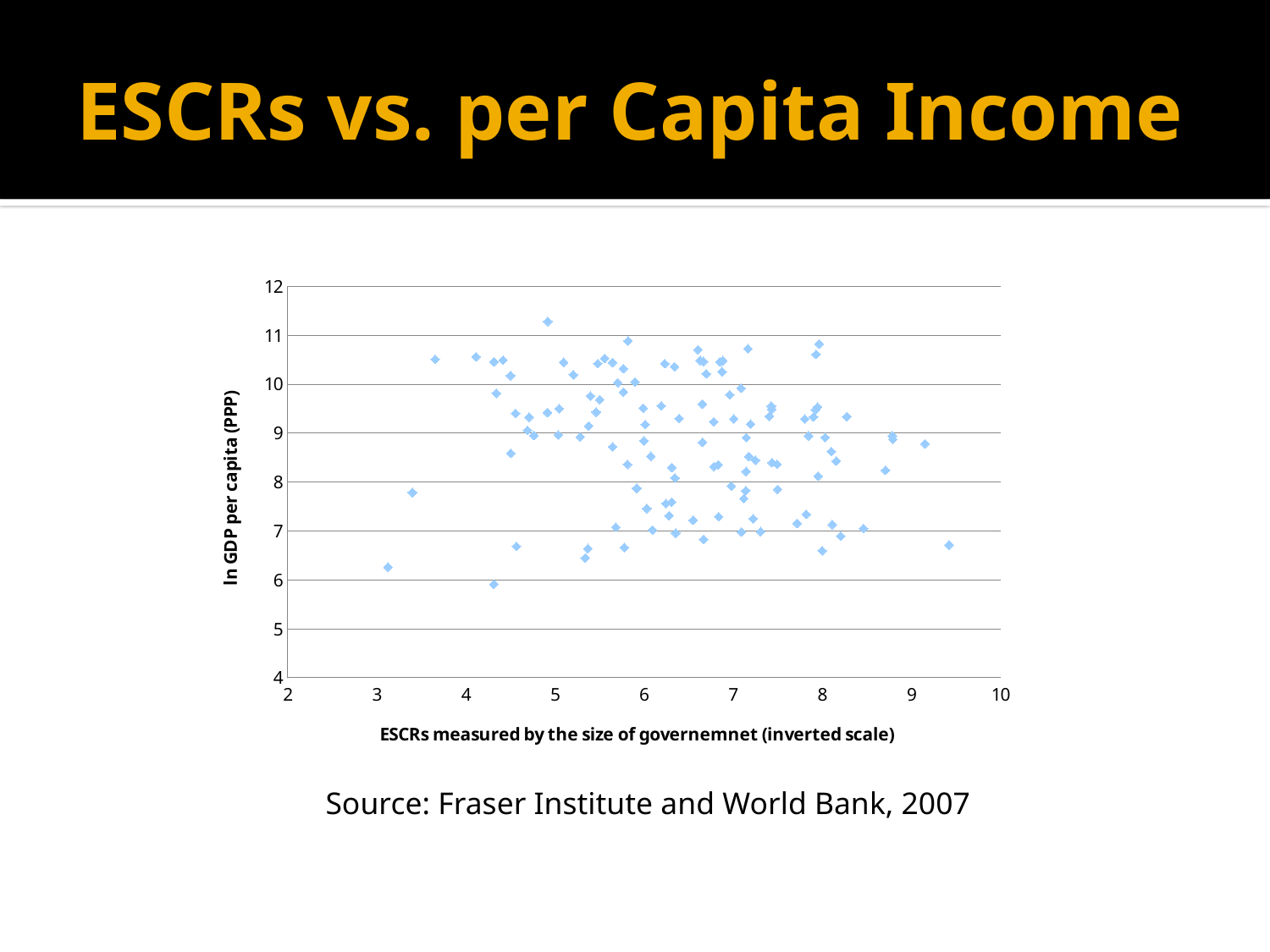
What is the title of the vertical axis of the chart? ln GDP per capita (PPP) Is the ln GDP per capita value of the rightmost point (near x = 9.4) greater or less than 6? greater What kind of chart is shown on the slide? scatter plot Is the ln GDP per capita value of the leftmost point (near x = 3) greater or less than 7? less What is the title of the horizontal axis of the chart? ESCRs measured by the size of governemnet (inverted scale) Is the lowest plotted ln GDP per capita value greater or less than 7? less